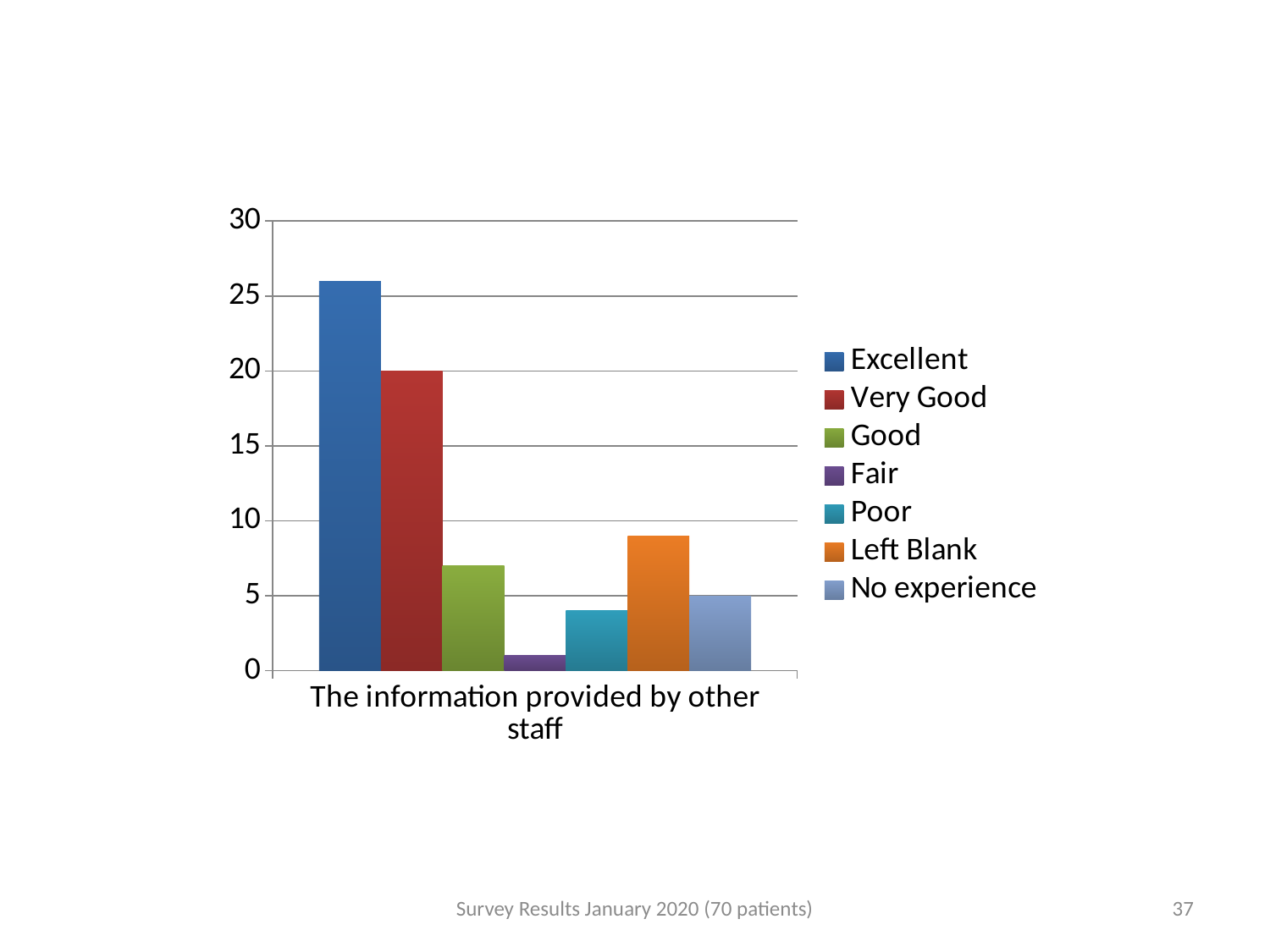
How many series does the legend list? 7 Is the value for Excellent greater or less than 25? greater What is the category label shown on the x axis? The information provided by other staff Which is larger, the value for Left Blank or the value for Good? Left Blank What is the value for No experience? 5 Is the value for Left Blank greater or less than 10? less Which rating has the highest bar? Excellent Which is larger, the value for Poor or the value for Fair? Poor What kind of chart is shown on the slide? Bar chart Is the value for Good greater or less than 5? greater What is the value for Very Good? 20 Which rating has the lowest bar? Fair